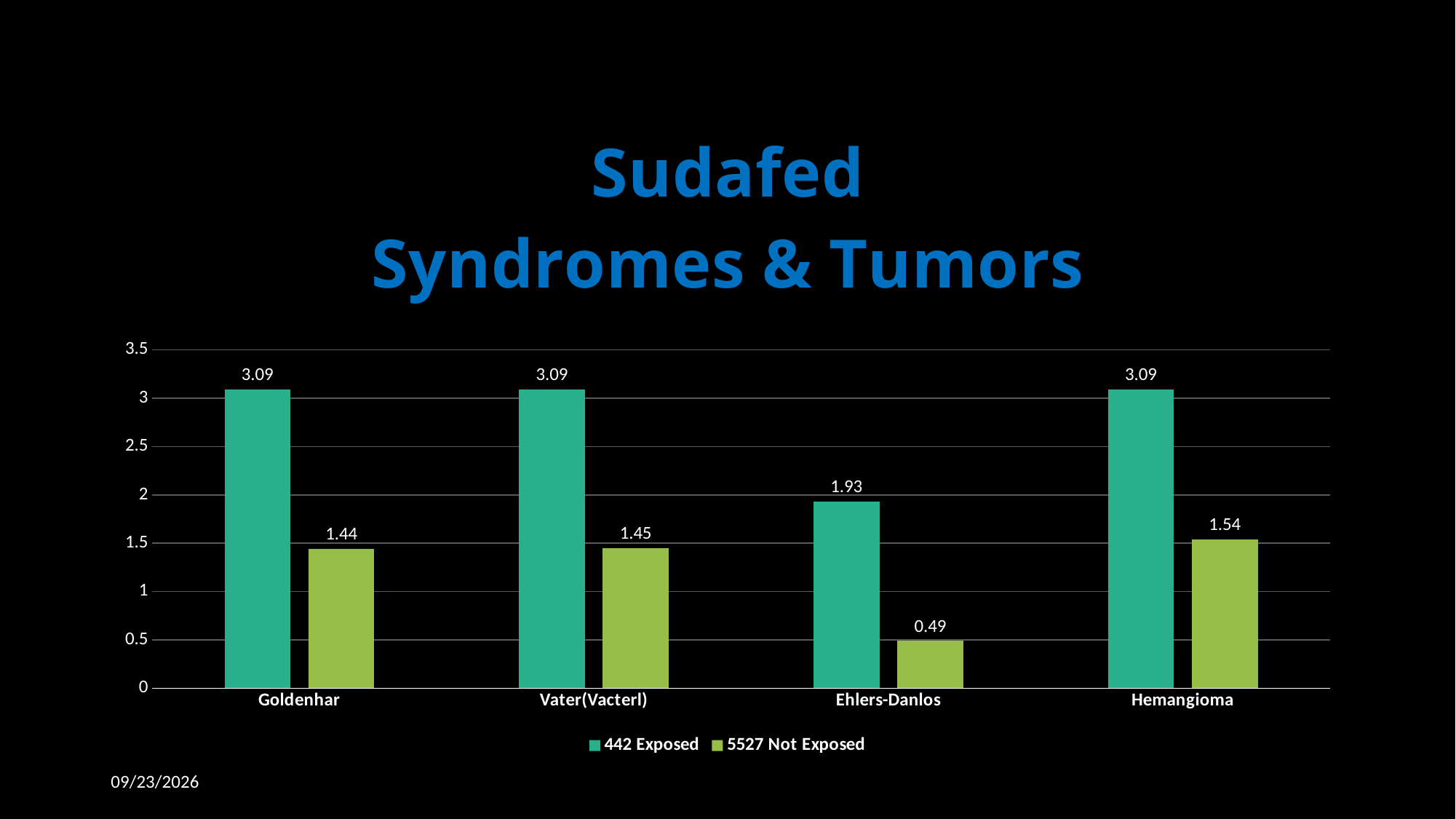
Which category has the lowest value in the 442 Exposed series? Ehlers-Danlos How many categories are shown on the x axis? 4 How many series does the legend list? 2 What is the value for Ehlers-Danlos in the 442 Exposed series? 1.93 What is the value for Ehlers-Danlos in the 5527 Not Exposed series? 0.49 What is the value for Hemangioma in the 5527 Not Exposed series? 1.54 What is the difference between the 442 Exposed and 5527 Not Exposed values for Goldenhar? 1.65 Which category has the highest value in the 5527 Not Exposed series? Hemangioma What kind of chart is shown on the slide? Bar chart Which is larger: the 442 Exposed value for Ehlers-Danlos or the 442 Exposed value for Hemangioma? Hemangioma What is the difference between the 442 Exposed and 5527 Not Exposed values for Ehlers-Danlos? 1.44 What is the value for Goldenhar in the 442 Exposed series? 3.09